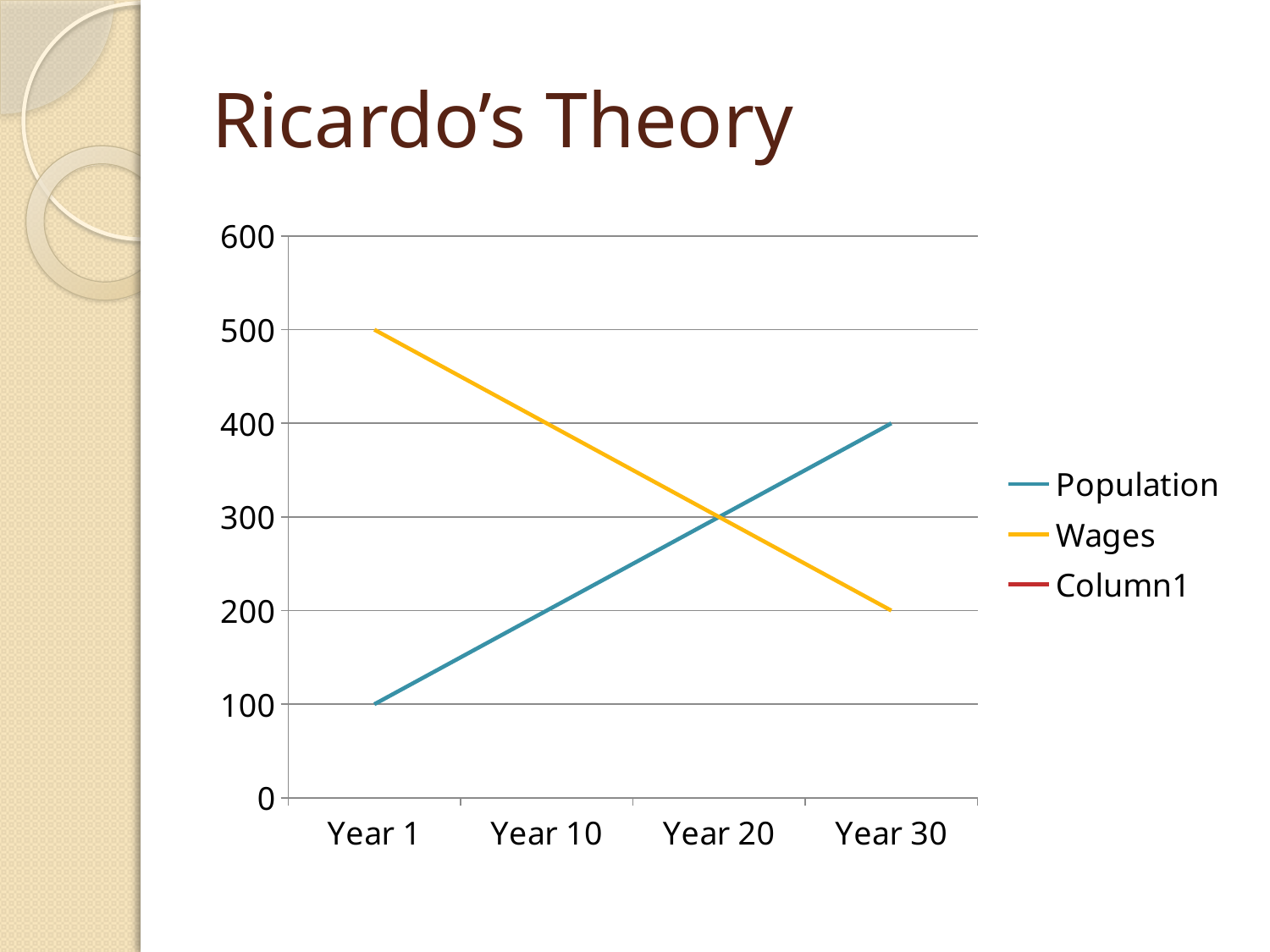
What is the Wages value at Year 30? 200 What is the difference between the Wages value at Year 1 and the Wages value at Year 30? 300 How many categories are shown on the x axis? 4 Which is larger at Year 1, Population or Wages? Wages What kind of chart is shown on the slide? line chart Does the Wages line rise or fall from Year 1 to Year 30? fall What is the Population value at Year 1? 100 What is the Wages value at Year 1? 500 What is the Population value at Year 30? 400 What is the title of the slide containing the chart? Ricardo's Theory Does the Population line rise or fall from Year 1 to Year 30? rise How many series does the legend list? 3